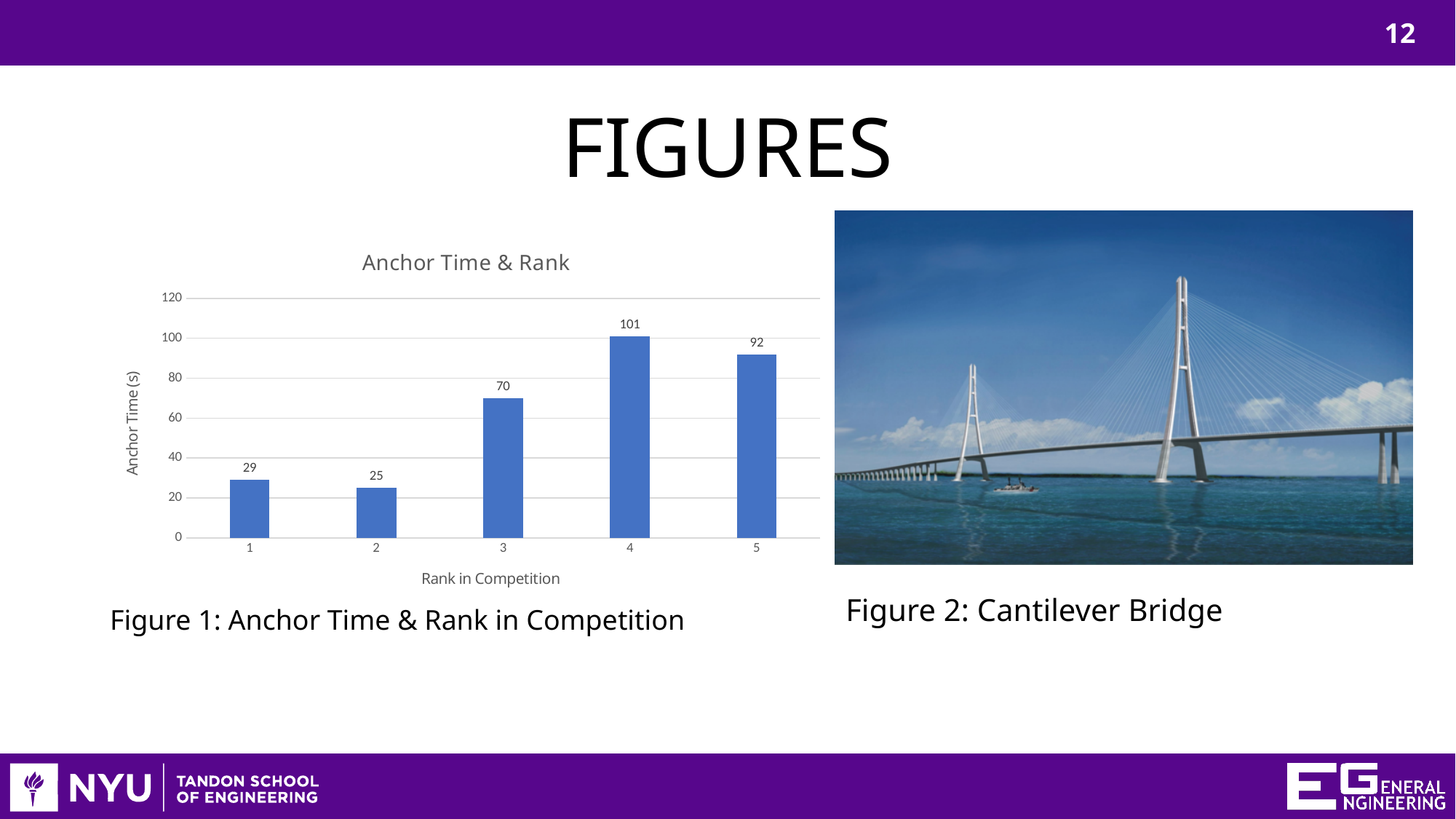
How many ranks are plotted in the Anchor Time & Rank chart? 5 What is the difference in anchor time between rank 1 and rank 2 in the Anchor Time & Rank chart? 4 What is the difference in anchor time between rank 4 and rank 3 in the Anchor Time & Rank chart? 31 Which has a larger anchor time in the Anchor Time & Rank chart, rank 3 or rank 5? rank 5 What kind of chart is the Anchor Time & Rank chart? bar chart Which rank has the lowest anchor time in the Anchor Time & Rank chart? 2 What is the label of the y axis in the Anchor Time & Rank chart? Anchor Time (s) Which rank has the highest anchor time in the Anchor Time & Rank chart? 4 Is the anchor time for rank 3 greater or less than 60 in the Anchor Time & Rank chart? greater What is the anchor time for rank 4 in the Anchor Time & Rank chart? 101 What is the anchor time for rank 5 in the Anchor Time & Rank chart? 92 What is the anchor time for rank 1 in the Anchor Time & Rank chart? 29